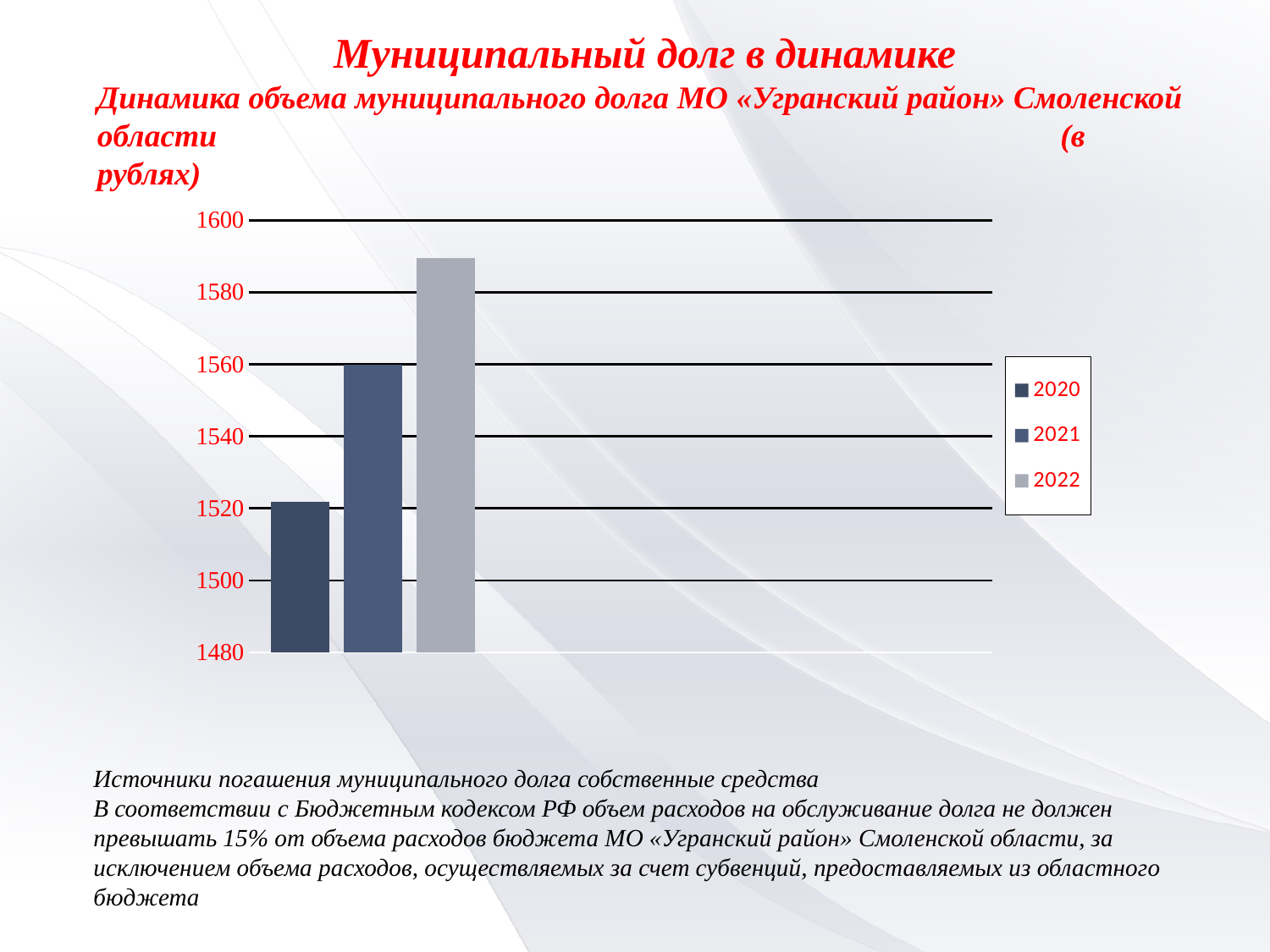
Is the value for 2022 greater or less than 1580? greater How many bars are plotted in the chart? 3 Which year has the highest municipal debt value? 2022 How many series does the legend list? 3 What kind of chart is shown on the slide? bar chart Which is larger, the value for 2021 or the value for 2020? 2021 Which year has the lowest municipal debt value? 2020 What are the entries listed in the chart legend? 2020, 2021, 2022 Do the values rise or fall from 2020 to 2022? rise Is the value for 2020 greater or less than 1500? greater Is the value for 2020 greater or less than 1540? less